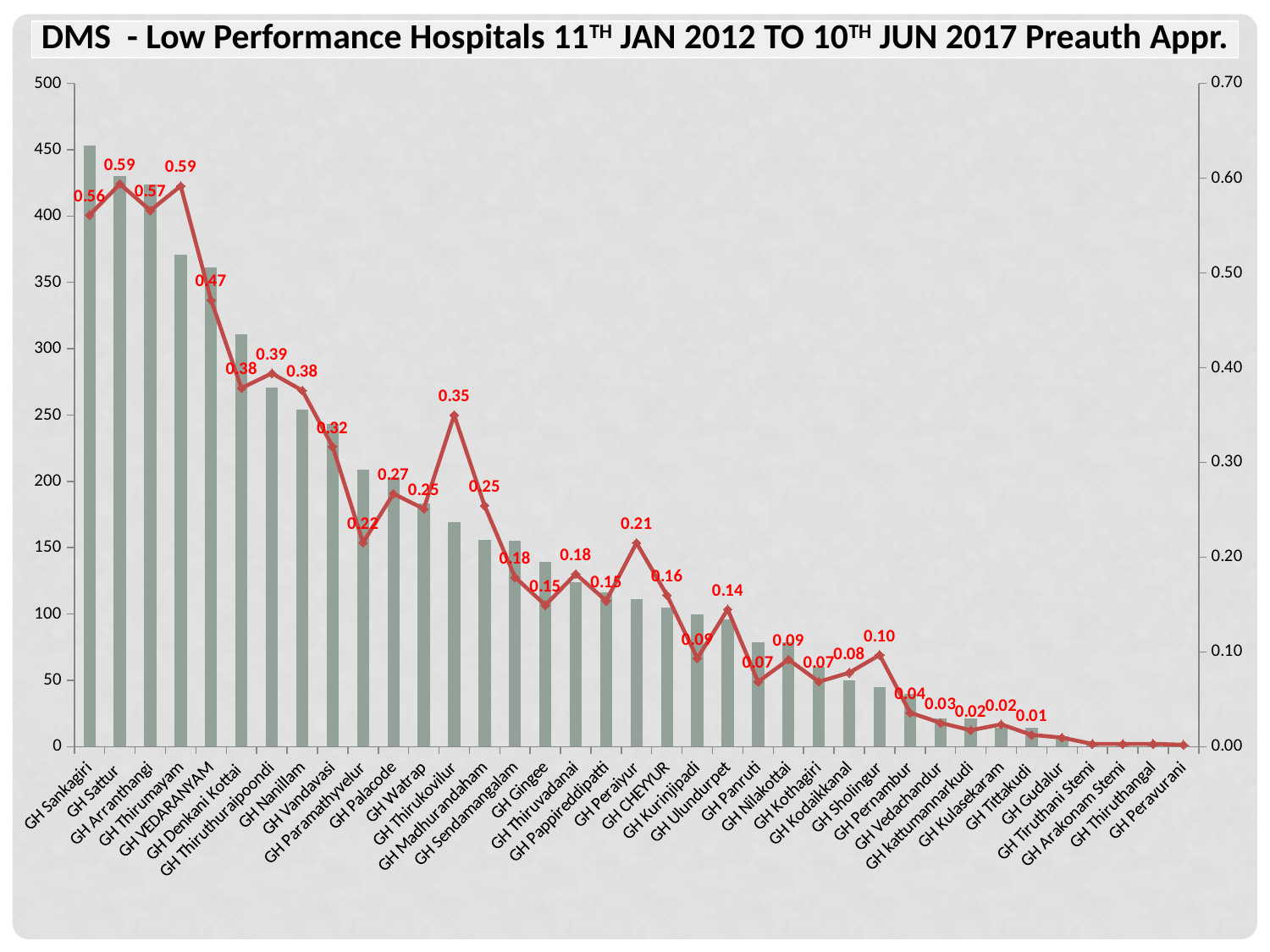
What kind of chart is this? Combination bar and line chart What is the line value shown for GH Pernambur? 0.04 Do the line values generally rise or fall from left to right? Fall What is the title of the chart? DMS - Low Performance Hospitals 11TH JAN 2012 TO 10TH JUN 2017 Preauth Appr. Is the bar value for GH Sankagiri greater or less than 400? greater What is the line value shown for GH Thirukovilur? 0.35 How many hospitals are shown on the x axis? 37 Which has the larger line value, GH Peraiyur or GH CHEYYUR? GH Peraiyur Which hospital has the tallest bar? GH Sankagiri What is the difference between the line values for GH Thirukovilur and GH Watrap? 0.10 What is the line value shown for GH VEDARANYAM? 0.47